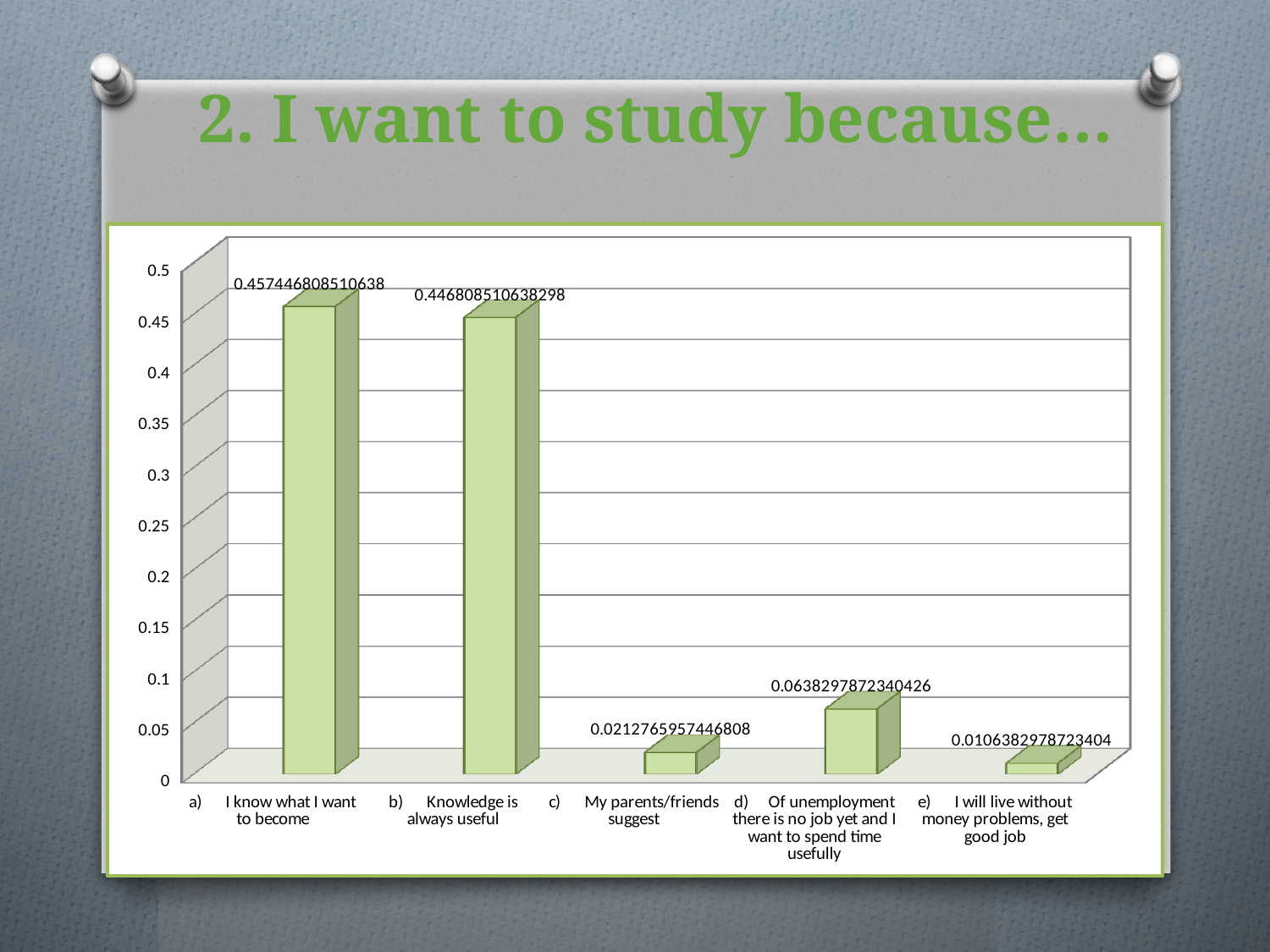
How many categories are shown on the chart? 5 Which is larger, the value for "c) My parents/friends suggest" or the value for "d) Of unemployment there is no job yet and I want to spend time usefully"? d) Of unemployment there is no job yet and I want to spend time usefully Which category has the lowest value? e) I will live without money problems, get good job What is the value for "b) Knowledge is always useful"? 0.446808510638298 What kind of chart is shown on the slide? bar chart Is the value for "d) Of unemployment there is no job yet and I want to spend time usefully" greater or less than 0.1? less What is the value for "c) My parents/friends suggest"? 0.0212765957446808 Which category has the highest value? a) I know what I want to become What is the value for "a) I know what I want to become"? 0.457446808510638 What is the value for "d) Of unemployment there is no job yet and I want to spend time usefully"? 0.0638297872340426 What is the value for "e) I will live without money problems, get good job"? 0.0106382978723404 What is the difference between the values for "d) Of unemployment there is no job yet and I want to spend time usefully" and "c) My parents/friends suggest"? 0.0425531914893618